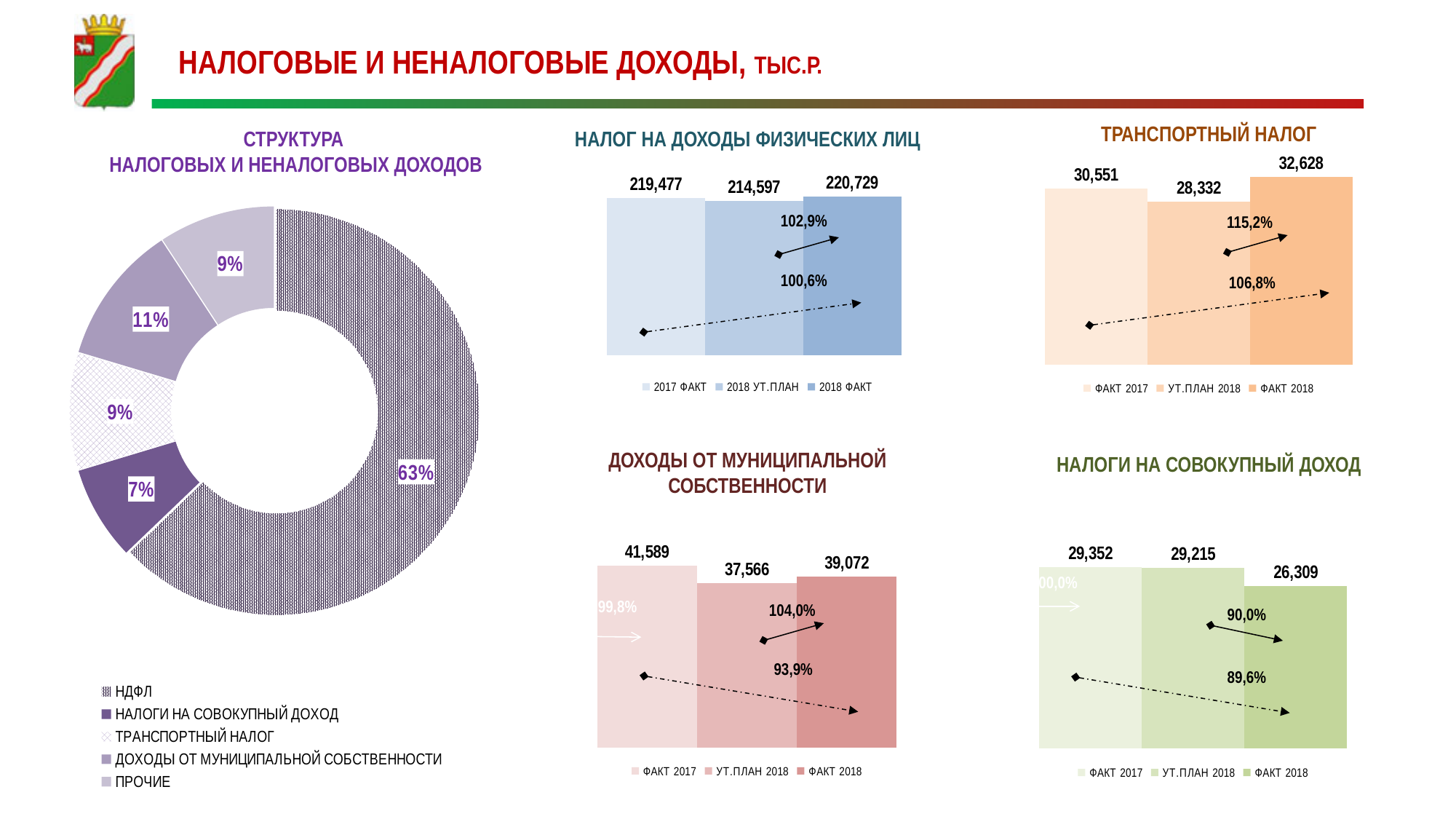
On the chart titled 'НАЛОГИ НА СОВОКУПНЫЙ ДОХОД', what is the value for ФАКТ 2018? 26,309 What kind of chart is 'НАЛОГИ НА СОВОКУПНЫЙ ДОХОД'? Bar chart On the chart titled 'СТРУКТУРА НАЛОГОВЫХ И НЕНАЛОГОВЫХ ДОХОДОВ', which category has the largest share? НДФЛ On the chart titled 'ДОХОДЫ ОТ МУНИЦИПАЛЬНОЙ СОБСТВЕННОСТИ', which is larger, ФАКТ 2017 or ФАКТ 2018? ФАКТ 2017 On the chart titled 'ТРАНСПОРТНЫЙ НАЛОГ', what is the value for ФАКТ 2018? 32,628 On the chart titled 'ДОХОДЫ ОТ МУНИЦИПАЛЬНОЙ СОБСТВЕННОСТИ', what is the value for ФАКТ 2017? 41,589 On the chart titled 'НАЛОГ НА ДОХОДЫ ФИЗИЧЕСКИХ ЛИЦ', what is the difference between 2018 ФАКТ and 2018 УТ.ПЛАН? 6,132 On the chart titled 'СТРУКТУРА НАЛОГОВЫХ И НЕНАЛОГОВЫХ ДОХОДОВ', what share does ДОХОДЫ ОТ МУНИЦИПАЛЬНОЙ СОБСТВЕННОСТИ have? 11% On the chart titled 'СТРУКТУРА НАЛОГОВЫХ И НЕНАЛОГОВЫХ ДОХОДОВ', how many categories does the legend list? 5 On the chart titled 'ТРАНСПОРТНЫЙ НАЛОГ', which series has the lowest value? УТ.ПЛАН 2018 On the chart titled 'НАЛОГ НА ДОХОДЫ ФИЗИЧЕСКИХ ЛИЦ', what is the value for 2018 ФАКТ? 220,729 On the chart titled 'СТРУКТУРА НАЛОГОВЫХ И НЕНАЛОГОВЫХ ДОХОДОВ', what share does НДФЛ have? 63%